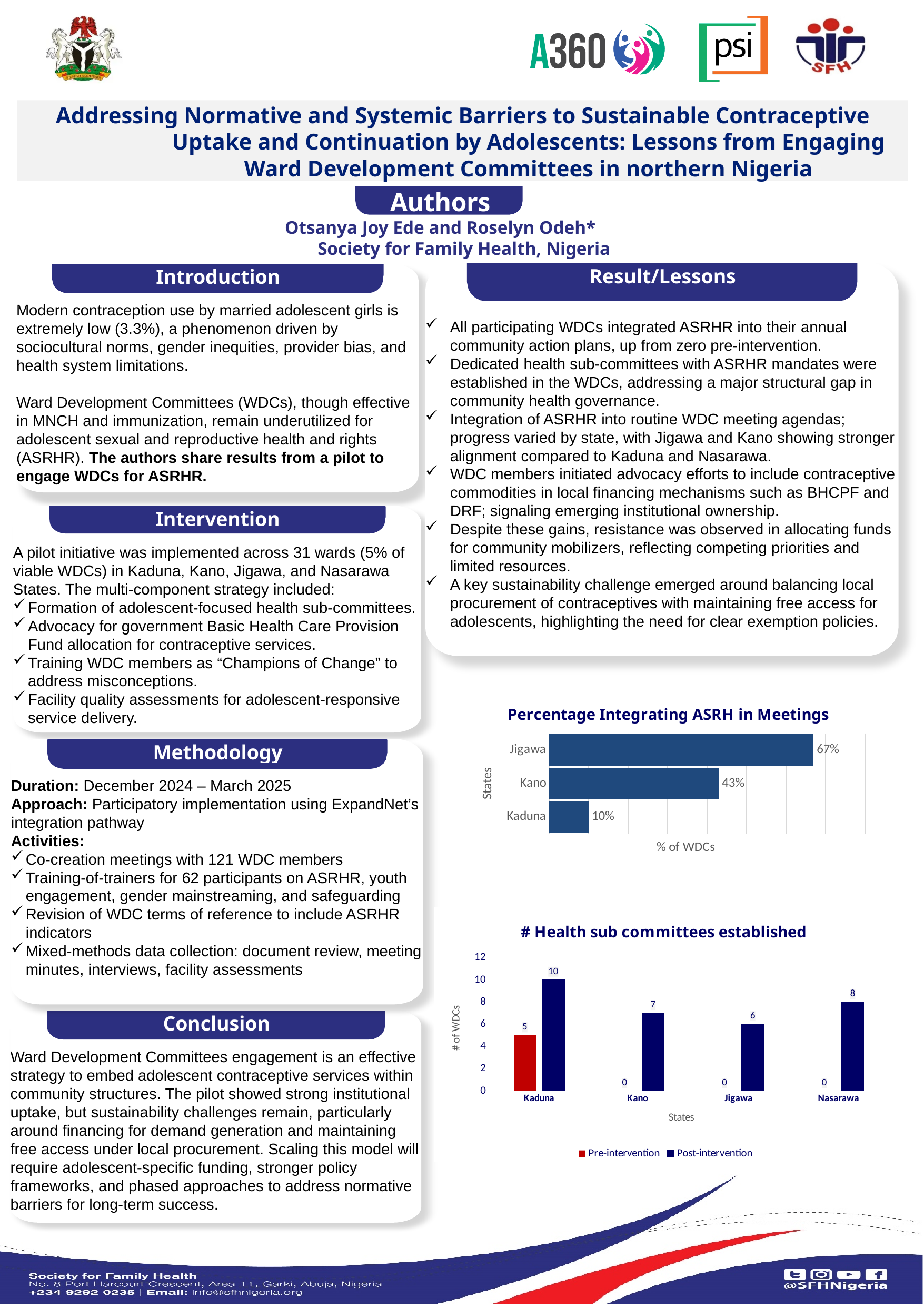
In the 'Percentage Integrating ASRH in Meetings' chart, which state has the lowest value? Kaduna In the 'Percentage Integrating ASRH in Meetings' chart, what is the difference between Jigawa and Kano? 24% What kind of chart is 'Percentage Integrating ASRH in Meetings'? Bar chart In the 'Percentage Integrating ASRH in Meetings' chart, what is the value for Jigawa? 67% In the '# Health sub committees established' chart, how many series does the legend list? 2 In the '# Health sub committees established' chart, is the post-intervention value for Nasarawa larger than that for Jigawa? Yes In the 'Percentage Integrating ASRH in Meetings' chart, what is the value for Kano? 43% In the 'Percentage Integrating ASRH in Meetings' chart, how many states are shown? 3 In the '# Health sub committees established' chart, what is the pre-intervention value for Kano? 0 In the '# Health sub committees established' chart, which state has the highest post-intervention value? Kaduna In the '# Health sub committees established' chart, what is the post-intervention value for Kaduna? 10 In the '# Health sub committees established' chart, what is the difference between the post-intervention and pre-intervention values for Kaduna? 5